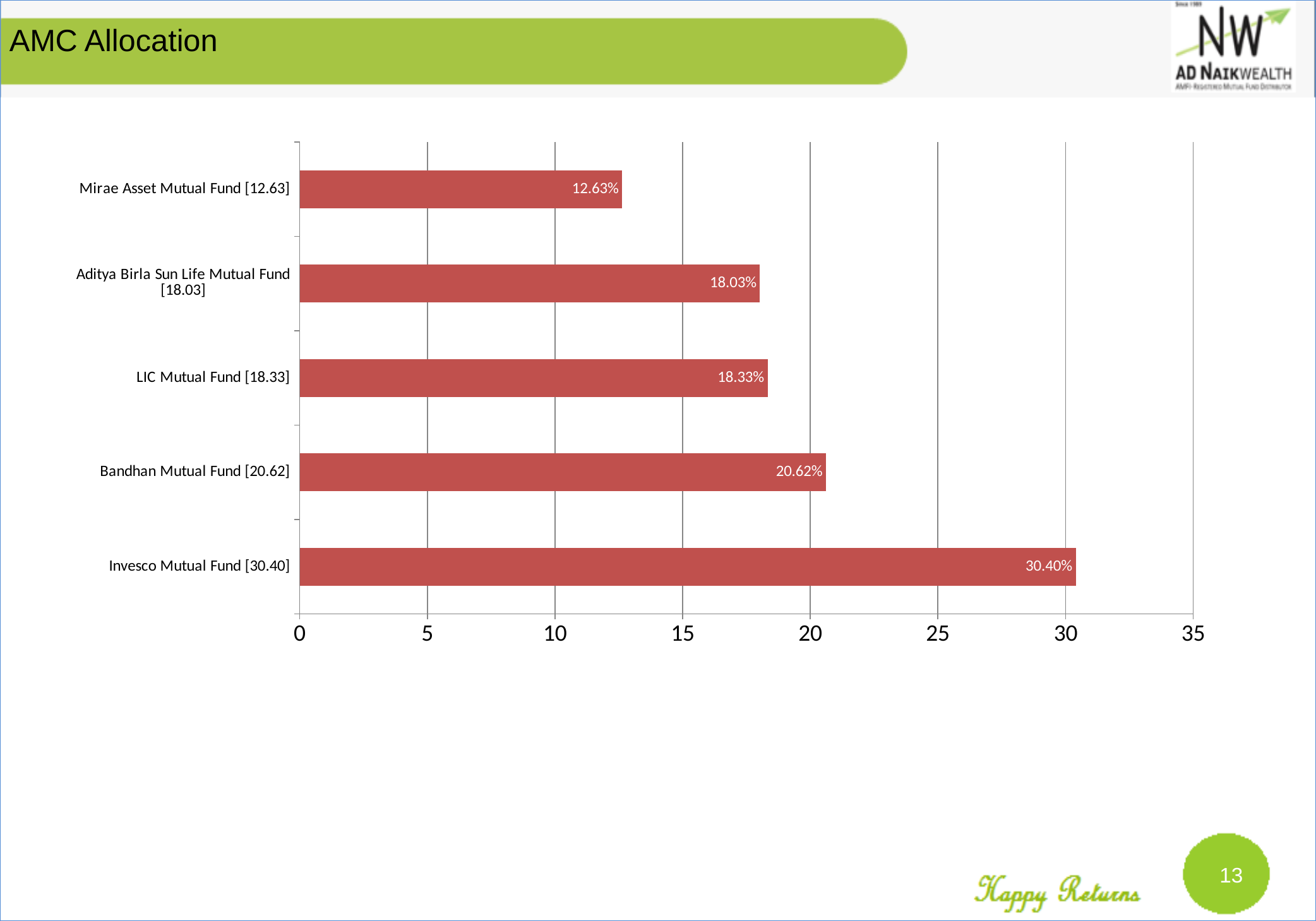
How many funds are shown in the chart? 5 What is the value for Mirae Asset Mutual Fund? 12.63% Which fund has the lowest allocation? Mirae Asset Mutual Fund What is the value for LIC Mutual Fund? 18.33% Is the value for Bandhan Mutual Fund greater or less than 20? greater What is the value for Aditya Birla Sun Life Mutual Fund? 18.03% What is the difference between the values for LIC Mutual Fund and Aditya Birla Sun Life Mutual Fund? 0.30% What kind of chart is shown on the slide? Bar chart What is the difference between the values for Invesco Mutual Fund and Bandhan Mutual Fund? 9.78% Which is larger, the value for Bandhan Mutual Fund or the value for Mirae Asset Mutual Fund? Bandhan Mutual Fund What is the value for Invesco Mutual Fund? 30.40% Which fund has the highest allocation? Invesco Mutual Fund